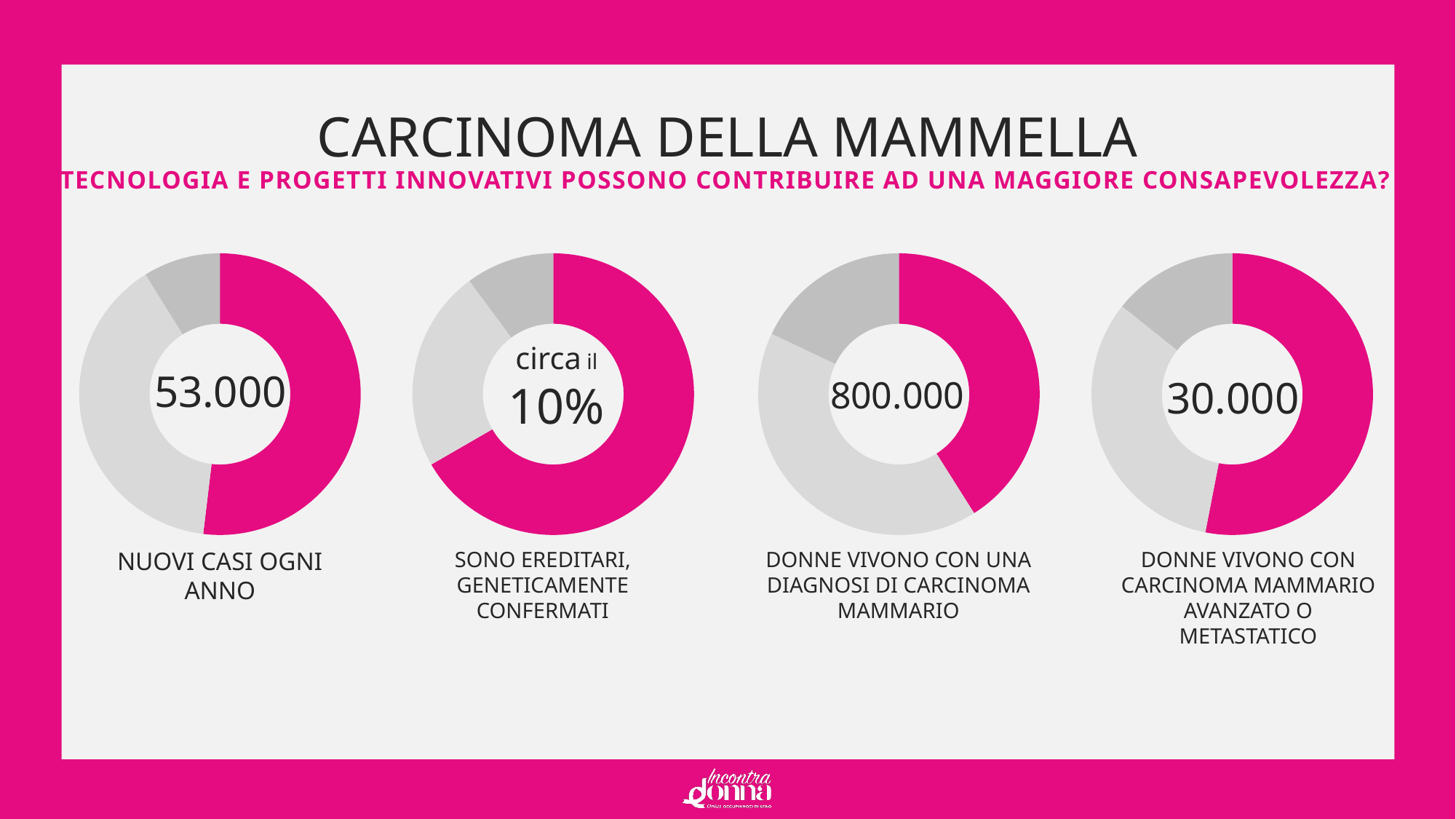
What number is shown in the centre of the third donut chart, labelled "DONNE VIVONO CON UNA DIAGNOSI DI CARCINOMA MAMMARIO"? 800.000 What number is shown in the centre of the first donut chart on the left, labelled "NUOVI CASI OGNI ANNO"? 53.000 Which donut chart shows the largest number in its centre? DONNE VIVONO CON UNA DIAGNOSI DI CARCINOMA MAMMARIO (800.000) What colour is the highlighted segment in each donut chart? Magenta/pink What is the difference between the number in the first donut (53.000) and the number in the fourth donut (30.000)? 23.000 What value is shown in the centre of the second donut chart, labelled "SONO EREDITARI, GENETICAMENTE CONFERMATI"? circa il 10% How many donut charts are shown on the slide? 4 What is the main title of the slide above the donut charts? CARCINOMA DELLA MAMMELLA What number is shown in the centre of the fourth donut chart on the right, labelled "DONNE VIVONO CON CARCINOMA MAMMARIO AVANZATO O METASTATICO"? 30.000 Which donut chart shows the smallest absolute number in its centre, among the charts labelled in thousands? DONNE VIVONO CON CARCINOMA MAMMARIO AVANZATO O METASTATICO (30.000) What kind of chart is used for each of the four figures on the slide? Donut chart Which is larger: the number of new cases per year (NUOVI CASI OGNI ANNO) or the number of women living with advanced or metastatic breast cancer? NUOVI CASI OGNI ANNO (53.000)